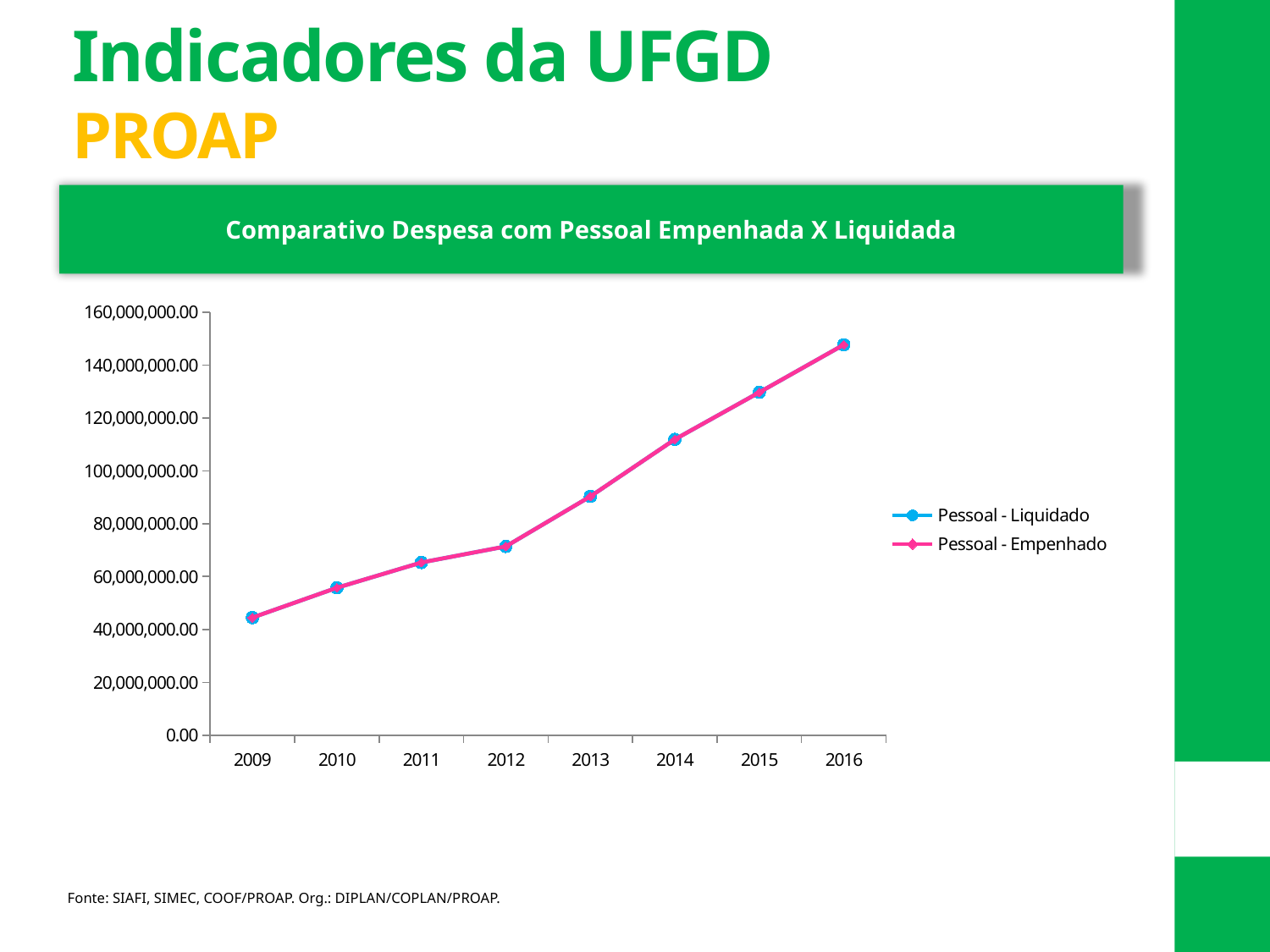
Which year has the highest value for Pessoal - Empenhado? 2016 Is the value for Pessoal - Liquidado in 2010 greater or less than 60,000,000.00? less Which year has the lowest value for Pessoal - Liquidado? 2009 Do the values for Pessoal - Liquidado rise or fall from 2009 to 2016? rise What kind of chart is shown on the slide? line chart How many years are plotted along the x axis? 8 Is the value for Pessoal - Liquidado in 2009 greater or less than 60,000,000.00? less How many series does the legend list? 2 Is the value for Pessoal - Empenhado in 2016 greater or less than 140,000,000.00? greater What is the title of the chart? Comparativo Despesa com Pessoal Empenhada X Liquidada